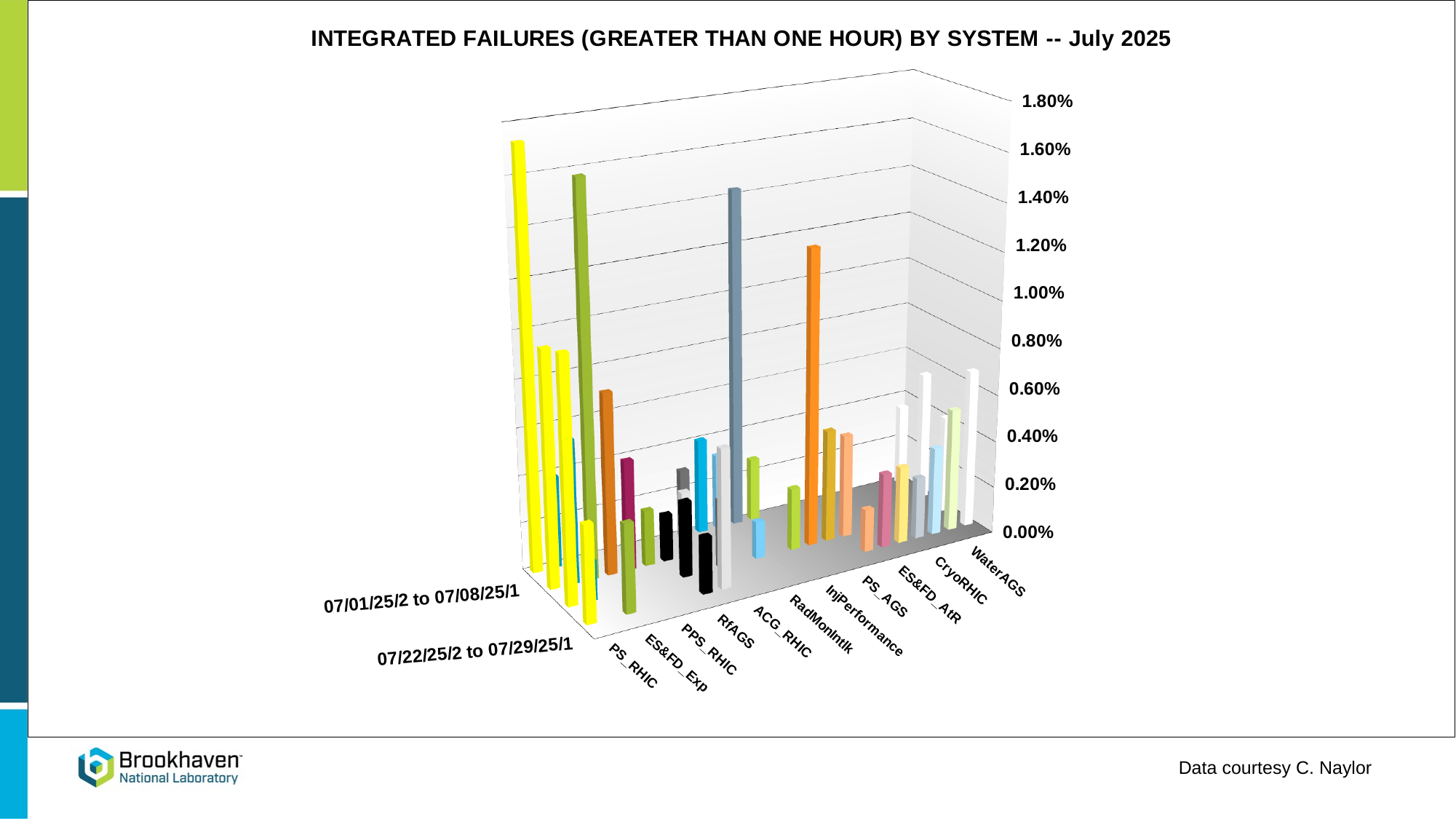
Is the tallest bar for InjPerformance greater or less than 0.60%? less Is the tallest bar for ES&FD_Exp greater or less than 1.00%? greater What kind of chart is shown on the slide? bar chart How many systems (categories) are listed along the horizontal axis of the chart? 11 Is the tallest bar for PS_RHIC greater or less than 1.00%? greater Which system has a taller tallest bar, PS_RHIC or RfAGS? PS_RHIC What is the title of the chart? INTEGRATED FAILURES (GREATER THAN ONE HOUR) BY SYSTEM -- July 2025 Which system has the tallest bar in the chart? PS_RHIC What is the highest value shown on the vertical axis of the chart? 1.80%